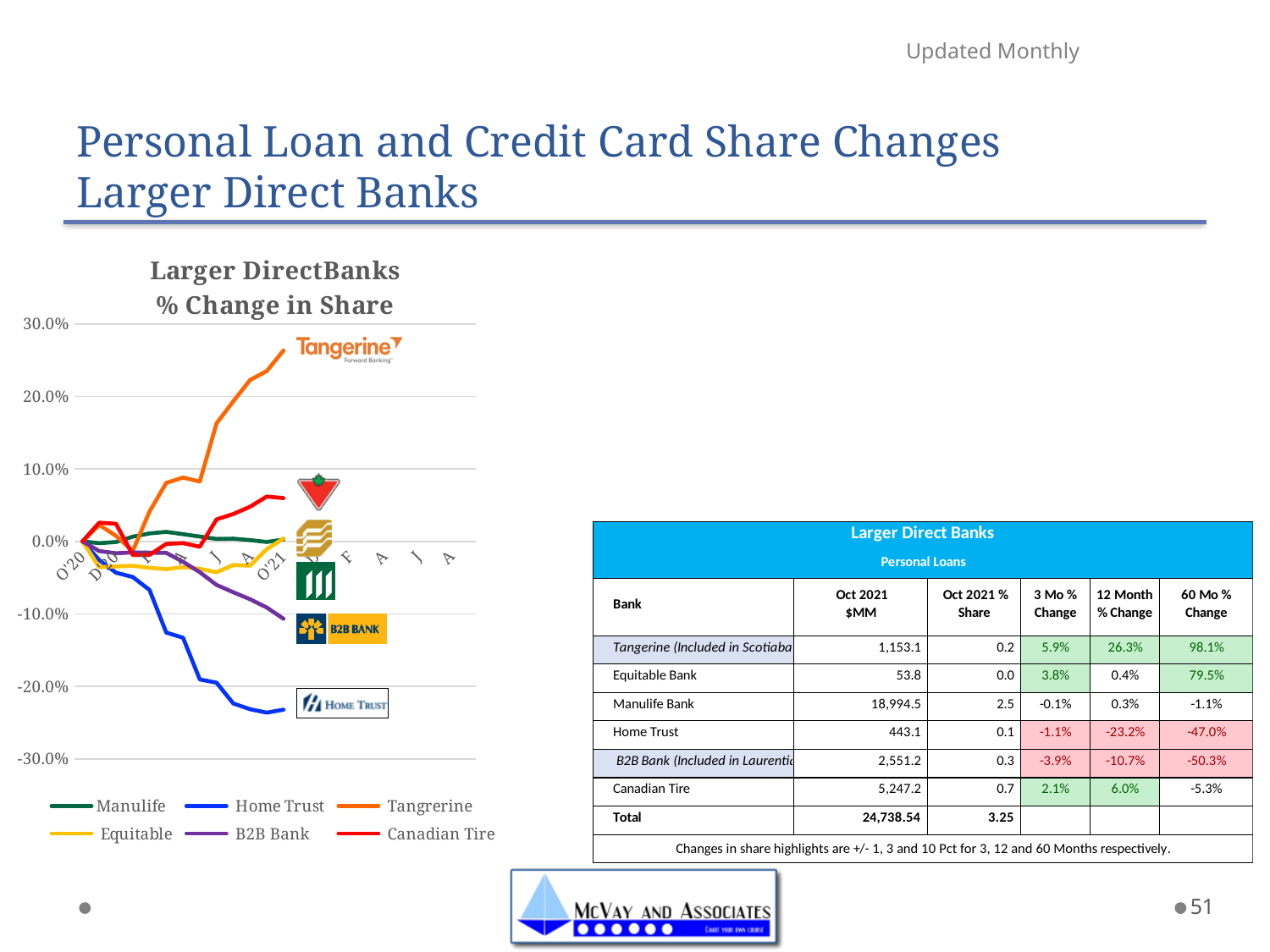
What kind of chart is shown on the slide? line chart Is the final value of the Home Trust line greater or less than -20.0%? less Does the Tangerine line rise or fall over the period shown on the chart? rise What colour is the Home Trust line in the chart? blue Which series reaches the lowest value at the right end of the "Larger DirectBanks % Change in Share" chart? Home Trust Is the final value of the Tangerine line greater or less than 20.0%? greater What is the title of the chart on the slide? Larger DirectBanks % Change in Share Does the Home Trust line rise or fall over the period shown on the chart? fall Which series reaches the highest value at the right end of the "Larger DirectBanks % Change in Share" chart? Tangerine Is the final value of the B2B Bank line greater or less than 0.0%? less At the right end of the chart, which is larger: the value for Canadian Tire or the value for B2B Bank? Canadian Tire How many series does the legend of the "Larger DirectBanks % Change in Share" chart list? 6